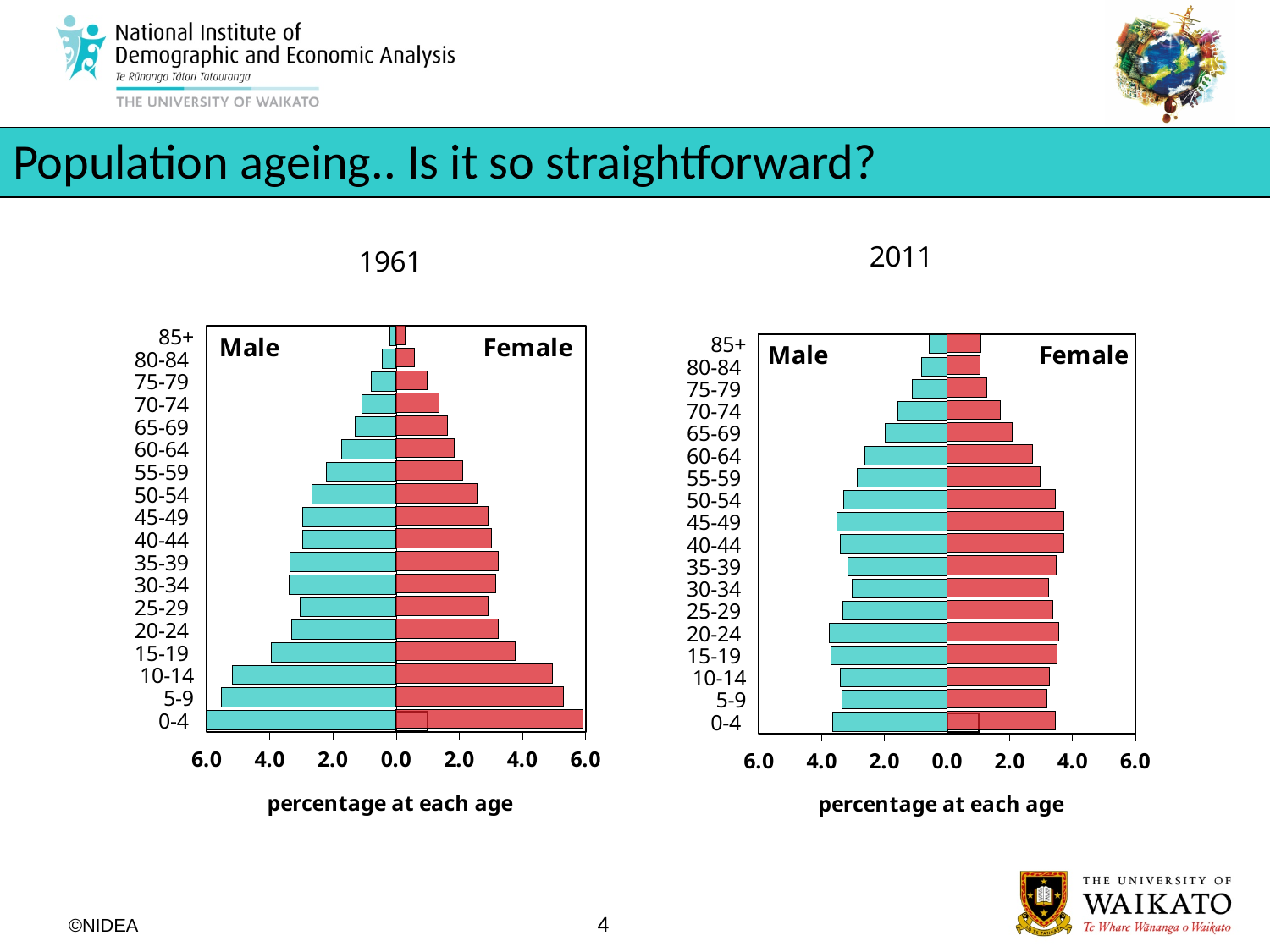
In the 2011 chart, is the Male value for the 20-24 age group greater or less than 2.0? greater In the 2011 chart, is the Female value for the 0-4 age group greater or less than 4.0? less In the 1961 chart, which age group has the shortest Male bar? 85+ What kind of chart is the 1961 chart on the left? bar chart What is the x-axis title of the 2011 chart? percentage at each age In the 1961 chart, which age group has the longest Female bar? 0-4 In the 1961 chart, do the bars get longer or shorter as the age group increases from 0-4 to 85+? shorter In the 2011 chart, which is larger: the Male value for 0-4 or the Male value for 85+? 0-4 In the 2011 chart, is the Male value for the 85+ age group greater or less than 2.0? less How many age groups are shown on the 2011 chart? 18 In the 1961 chart, what colour are the Female bars? red